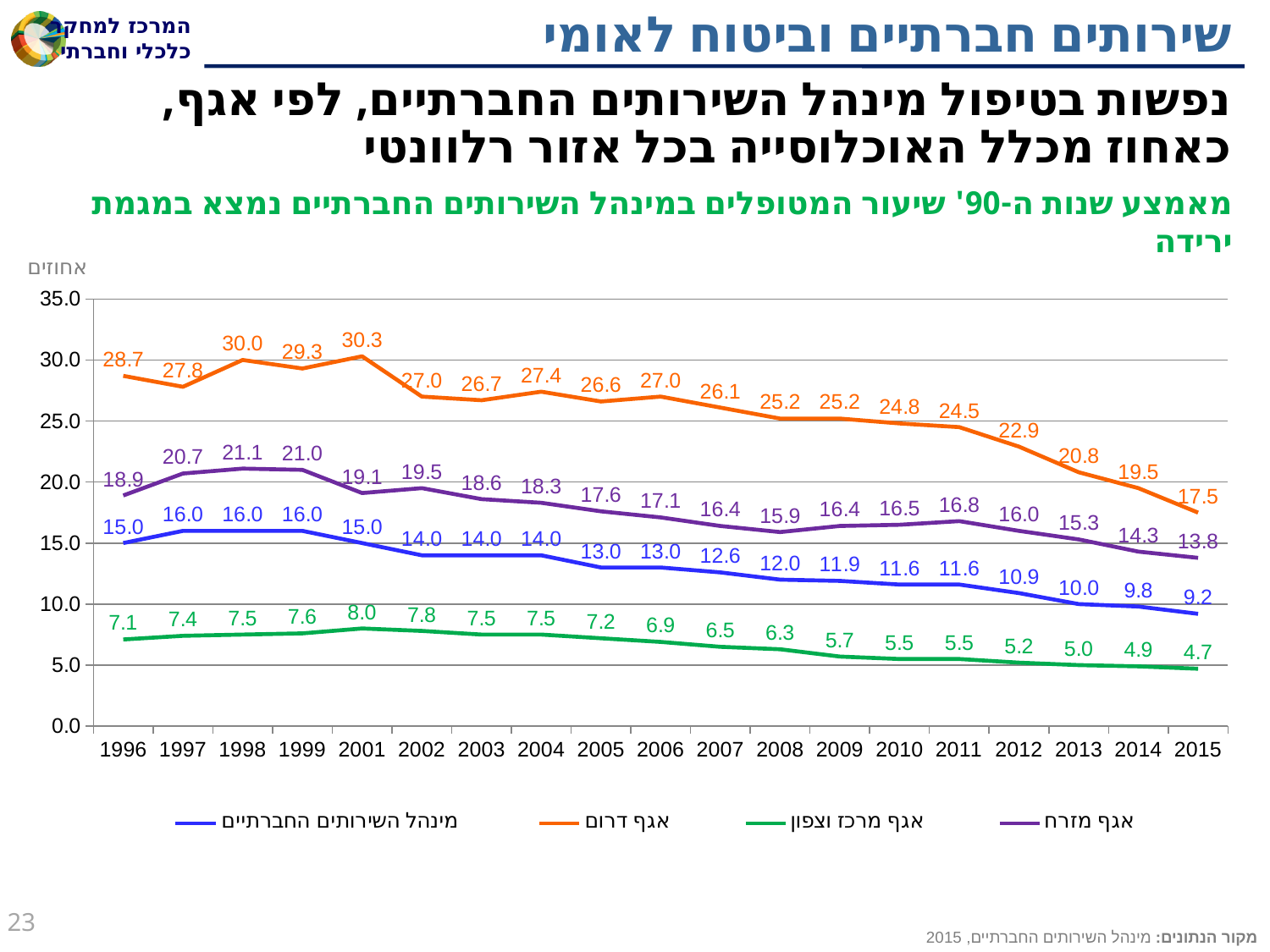
In which year is the value for אגף מרכז וצפון lowest? 2015 What is the value for אגף מזרח in 2011? 16.8 What kind of chart is shown on the slide? line chart Does the value for מינהל השירותים החברתיים rise or fall from 2001 to 2015? fall In which year does אגף דרום reach its highest value? 2001 How many series does the legend list? 4 Which series has the higher value in 2015, אגף מזרח or מינהל השירותים החברתיים? אגף מזרח What is the value for אגף דרום in 2001? 30.3 What is the difference between the אגף דרום values in 1996 and 2015? 11.2 What is the value for מינהל השירותים החברתיים in 1997? 16.0 What is the value for אגף מרכז וצפון in 2015? 4.7 How many years are shown on the x axis? 19